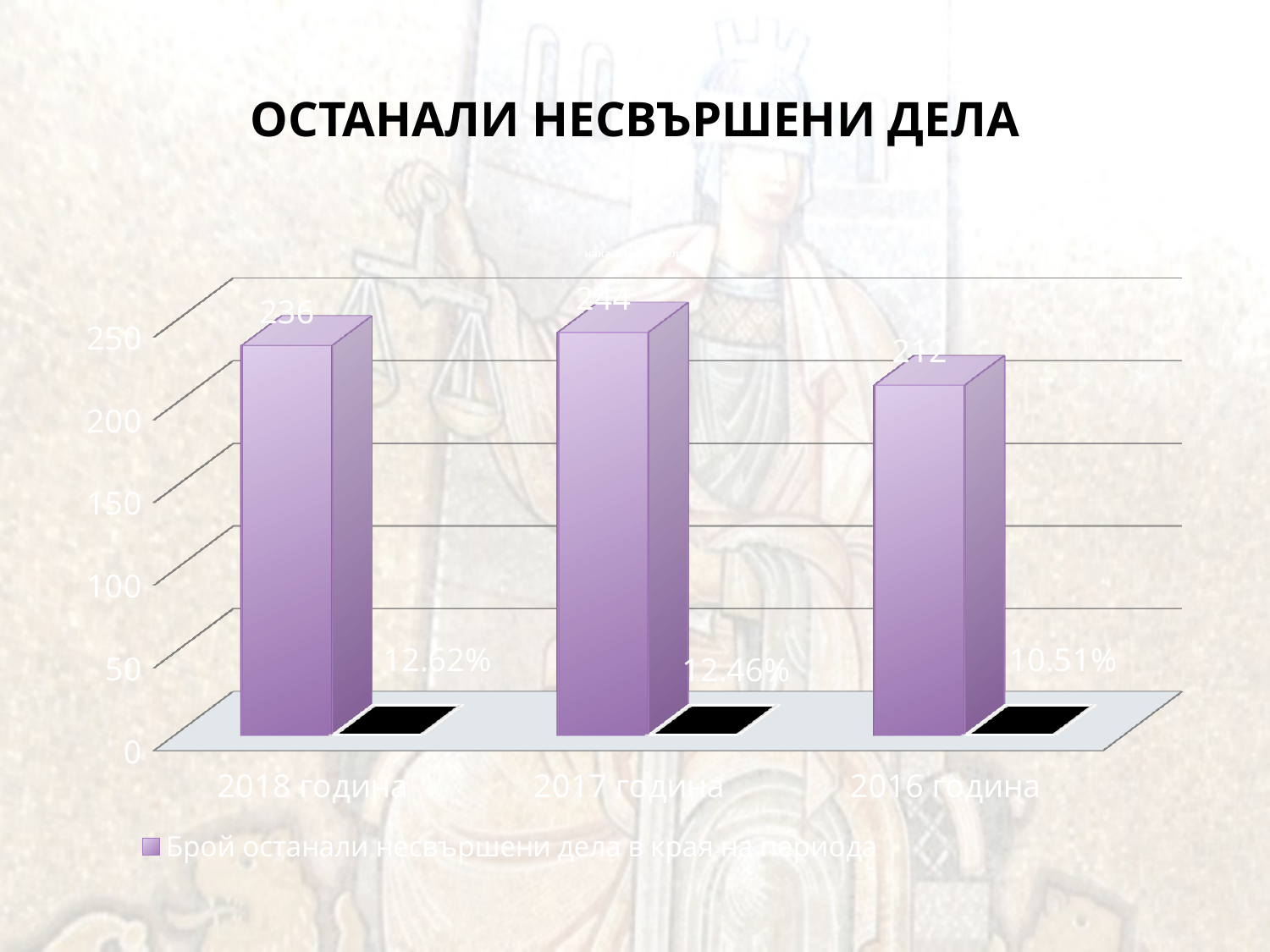
Is the value for 2016 година greater or less than 200? greater What is the value for 2017 година? 244 How many year categories are shown on the x axis? 3 Which is larger, the value for 2018 година or the value for 2016 година? 2018 година Which year has the highest number of remaining unfinished cases? 2017 година What is the value for 2016 година? 212 What is the difference between the values for 2017 година and 2016 година? 32 Which year has the lowest number of remaining unfinished cases? 2016 година What is the percentage label shown for 2016 година? 10.51% What is the difference between the values for 2017 година and 2018 година? 8 What kind of chart is shown on the slide? bar chart What is the value for 2018 година? 236